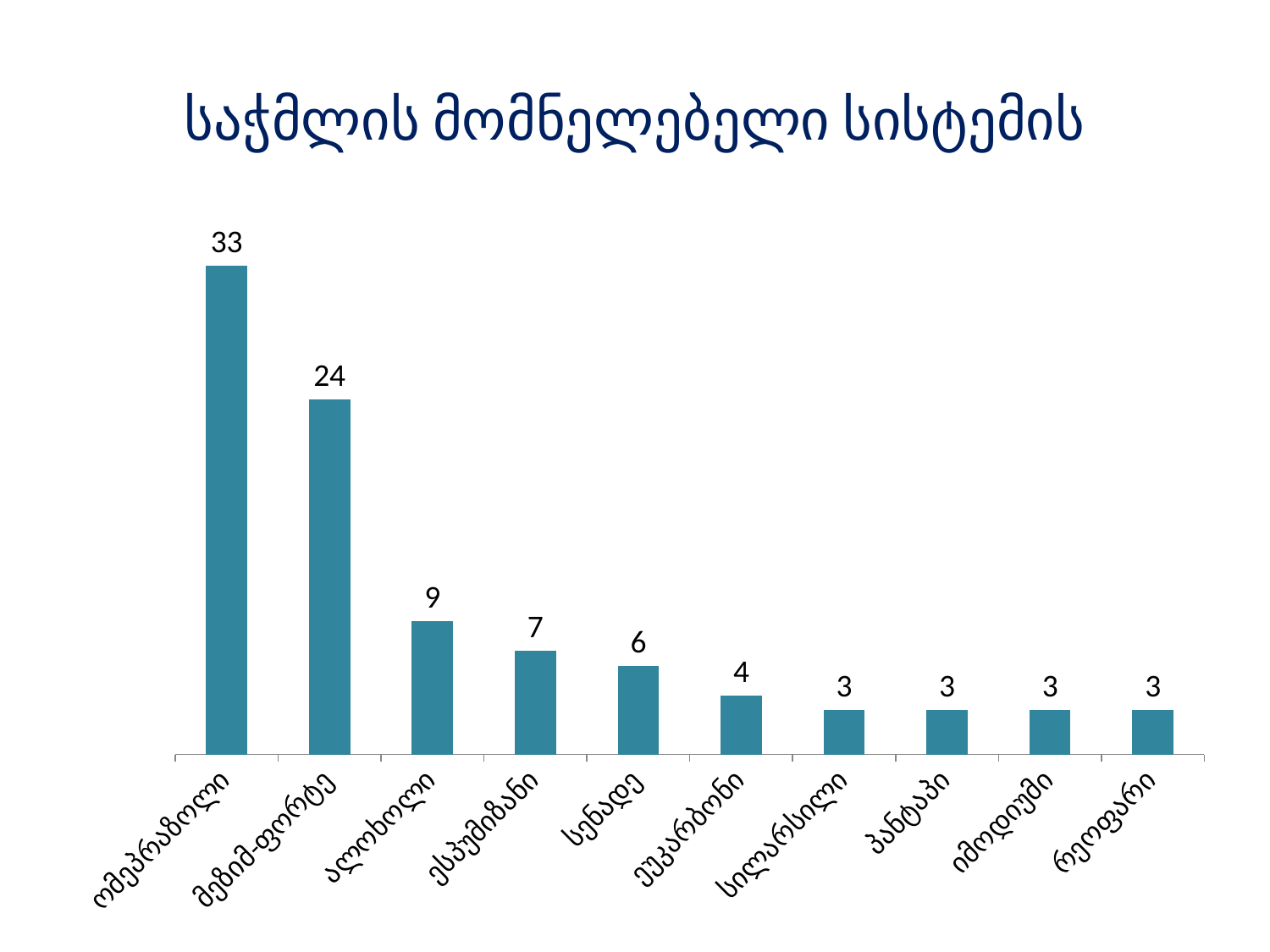
How many categories are shown on the x axis? 10 Which category has the highest value? ომეპრაზოლი Which is larger, the value for ალოხოლი or the value for ესპუმიზანი? ალოხოლი What is the value for მეზიმ-ფორტე? 24 Do the values rise or fall from left to right along the x axis? fall What is the title of the chart? საჭმლის მომნელებელი სისტემის What is the value for ესპუმიზანი? 7 What is the difference between the values for ალოხოლი and სენადე? 3 What is the difference between the values for ომეპრაზოლი and მეზიმ-ფორტე? 9 What is the value for ომეპრაზოლი? 33 What is the value for ეუკარბონი? 4 What kind of chart is shown on the slide? bar chart